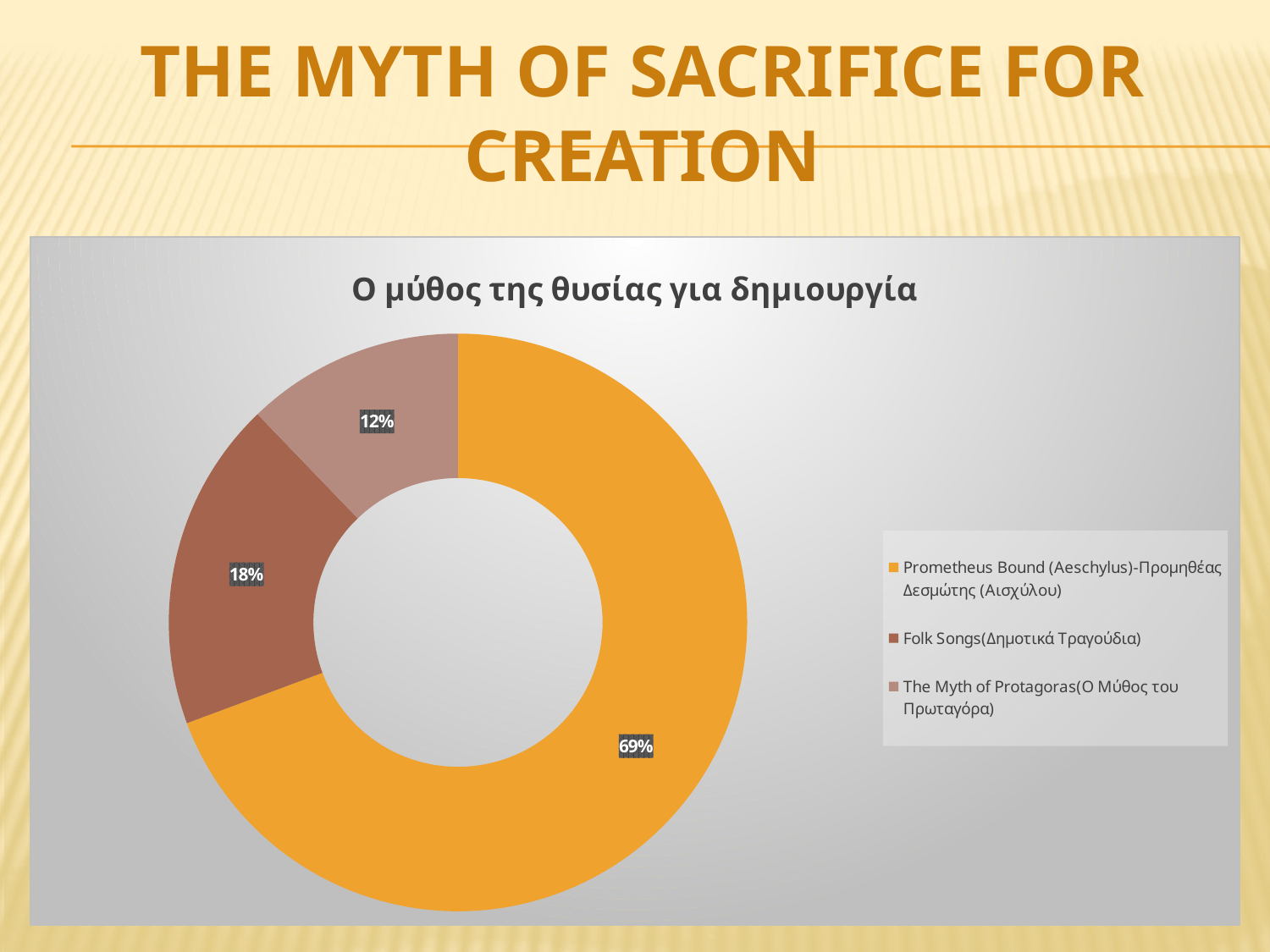
What is the difference in percentage points between Prometheus Bound and Folk Songs? 51 What share of the chart does Folk Songs account for? 18% How many categories are shown in the chart? 3 What is the title of the chart? Ο μύθος της θυσίας για δημιουργία Which category has the smallest share of the chart? The Myth of Protagoras Which colour represents Folk Songs in the chart? Brown Which has a larger share, Folk Songs or The Myth of Protagoras? Folk Songs What share of the chart does The Myth of Protagoras account for? 12% What kind of chart is shown on the slide? Doughnut chart What is the difference in percentage points between Folk Songs and The Myth of Protagoras? 6 Which category has the largest share of the chart? Prometheus Bound (Aeschylus) What share of the chart does Prometheus Bound (Aeschylus) account for? 69%